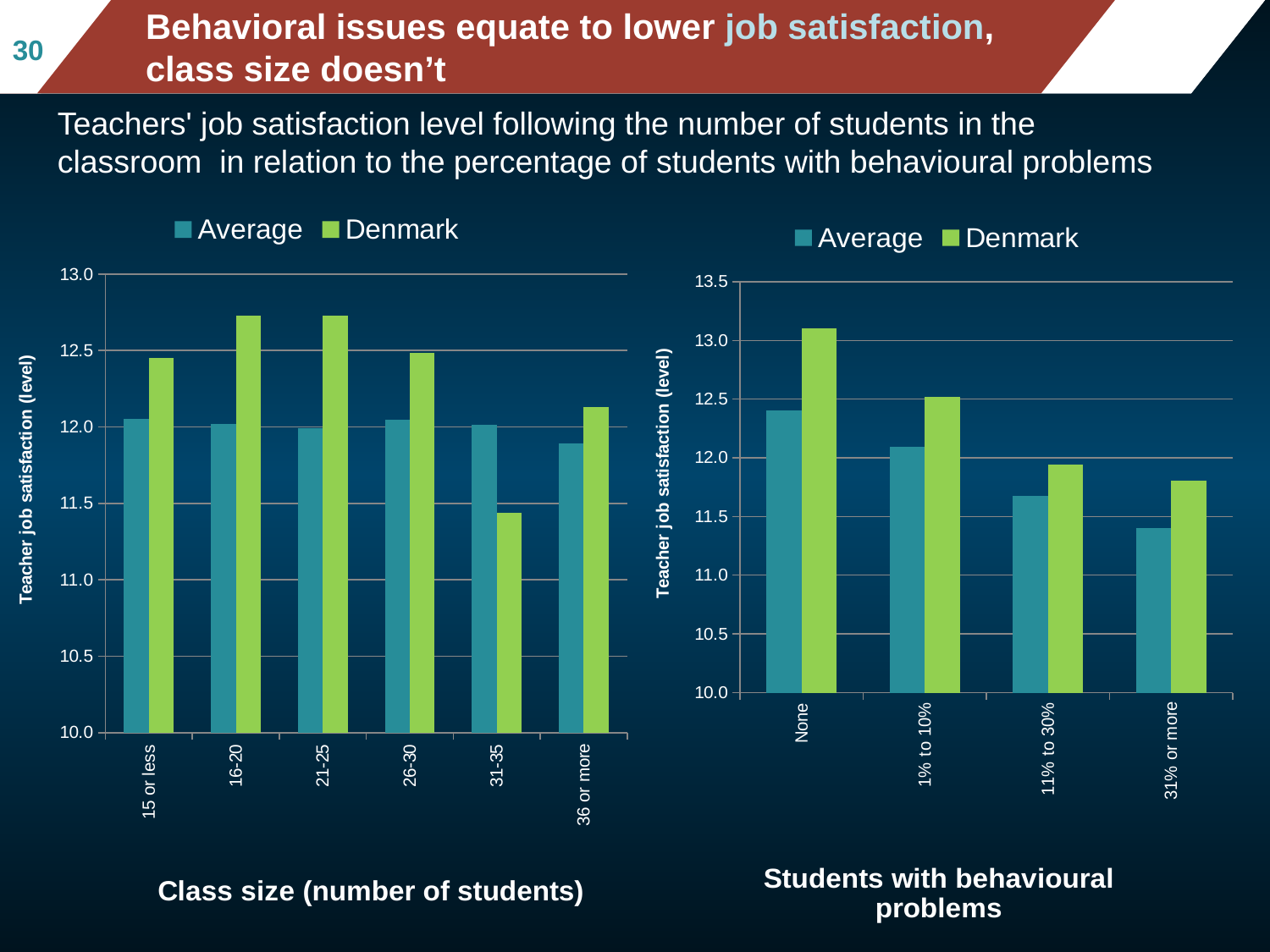
In the right chart, 'Students with behavioural problems', which category has the highest Denmark value? None What is the x-axis title of the right chart? Students with behavioural problems In the right chart, 'Students with behavioural problems', which category has the lowest Average value? 31% or more In the left chart, 'Class size (number of students)', is the Denmark value for 16-20 greater or less than 12.5? greater What kind of chart is the left chart, 'Class size (number of students)'? bar chart In the left chart, 'Class size (number of students)', which class size has the lowest Denmark value? 31-35 How many class-size categories are shown on the x axis of the left chart? 6 In the right chart, 'Students with behavioural problems', which is larger for the None category: Average or Denmark? Denmark In the right chart, 'Students with behavioural problems', is the Average value for 31% or more greater or less than 11.5? less In the right chart, 'Students with behavioural problems', do the Average values rise or fall as you move from None to 31% or more? fall In the left chart, 'Class size (number of students)', which is larger for the 31-35 category: Average or Denmark? Average How many series does the legend of the right chart, 'Students with behavioural problems', list? 2